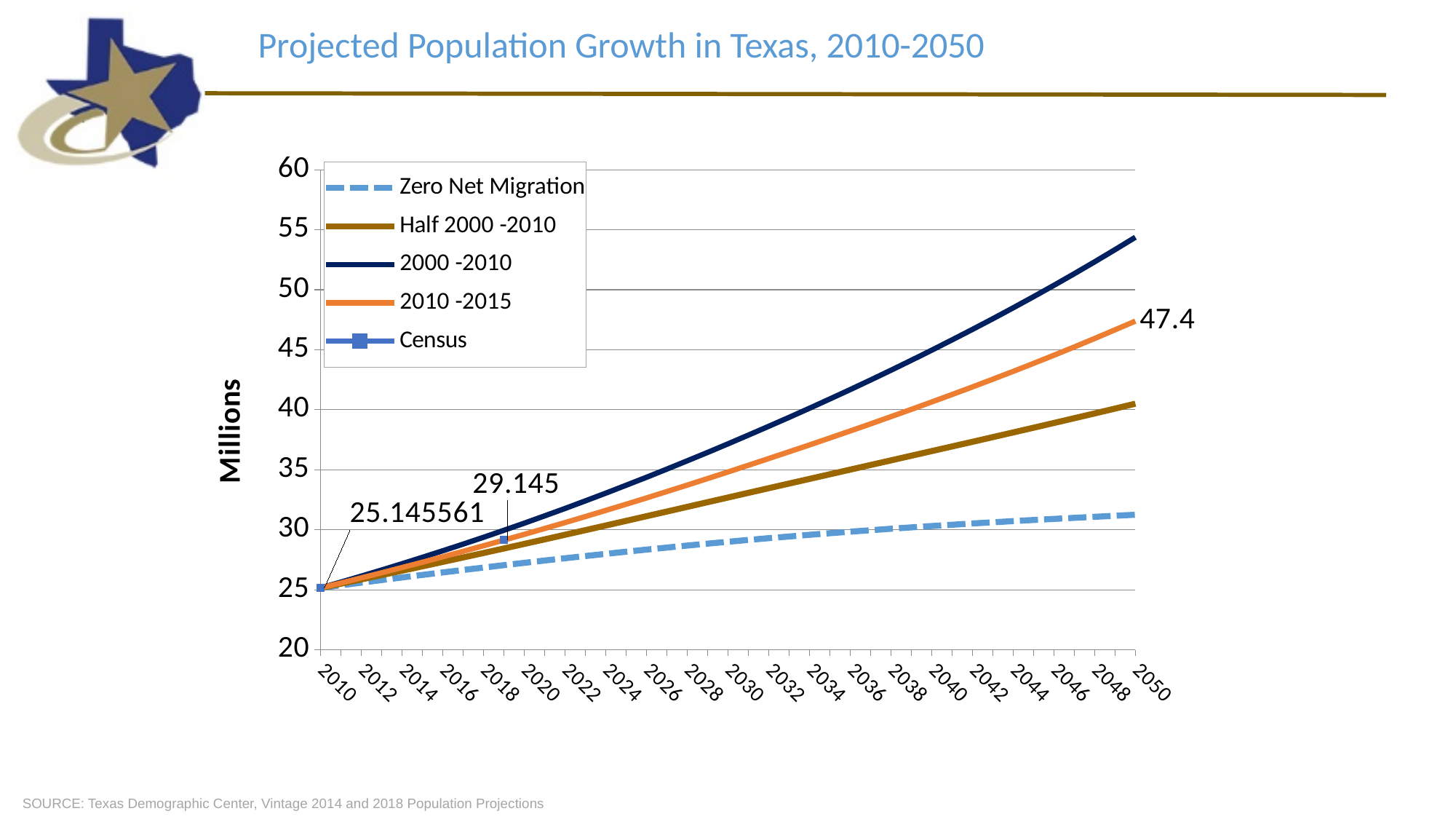
Which series has the highest value in 2050? 2000 -2010 What is the label on the vertical axis? Millions Is the value for the 2000 -2010 series in 2050 greater or less than 50? greater What is the Census value labelled for 2018? 29.145 How many series does the legend list? 5 Which series has the lowest value in 2050? Zero Net Migration What value is labelled for the 2010 -2015 series in 2050? 47.4 In 2050, which is larger: the 2010 -2015 series or the Half 2000 -2010 series? 2010 -2015 Is the value for the Half 2000 -2010 series in 2050 greater or less than 45? less What is the Census value labelled for 2010? 25.145561 What kind of chart is shown on the slide? line chart Do the projected values rise or fall from 2010 to 2050? rise